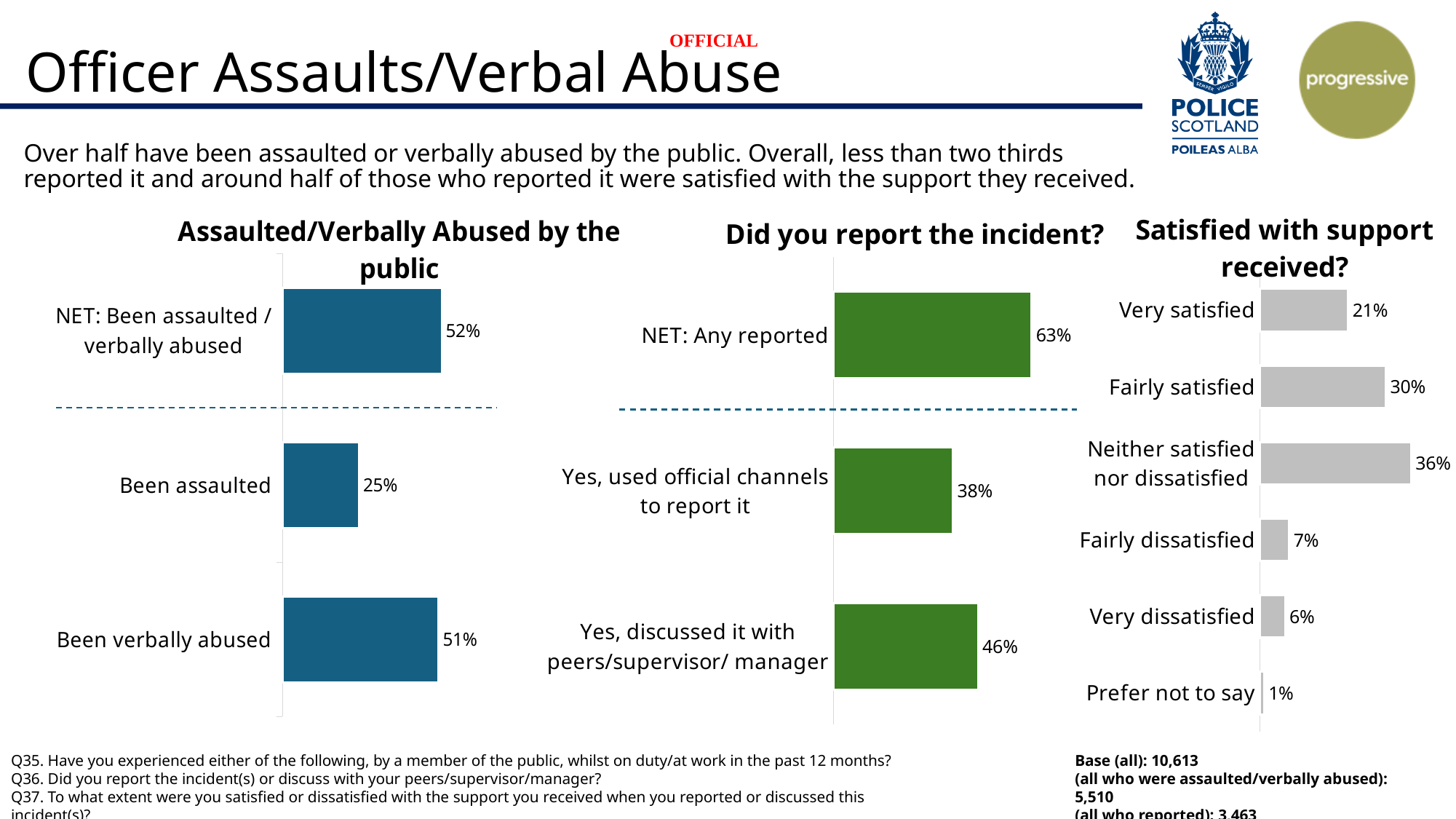
In the 'Satisfied with support received?' chart, which category has the lowest value? Prefer not to say In the 'Did you report the incident?' chart, what is the value for 'NET: Any reported'? 63% In the 'Did you report the incident?' chart, which is larger: 'Yes, used official channels to report it' or 'Yes, discussed it with peers/supervisor/ manager'? Yes, discussed it with peers/supervisor/ manager In the 'Assaulted/Verbally Abused by the public' chart, what is the value for 'Been assaulted'? 25% How many categories are shown in the 'Satisfied with support received?' chart? 6 In the 'Satisfied with support received?' chart, what is the difference between 'Fairly satisfied' and 'Very satisfied'? 9% What type of chart is the 'Did you report the incident?' chart? Bar chart In the 'Did you report the incident?' chart, what is the value for 'Yes, discussed it with peers/supervisor/ manager'? 46% In the 'Satisfied with support received?' chart, which category has the highest value? Neither satisfied nor dissatisfied In the 'Assaulted/Verbally Abused by the public' chart, what is the value for 'NET: Been assaulted / verbally abused'? 52% In the 'Assaulted/Verbally Abused by the public' chart, what is the difference between 'Been verbally abused' and 'Been assaulted'? 26% In the 'Satisfied with support received?' chart, what is the value for 'Fairly dissatisfied'? 7%